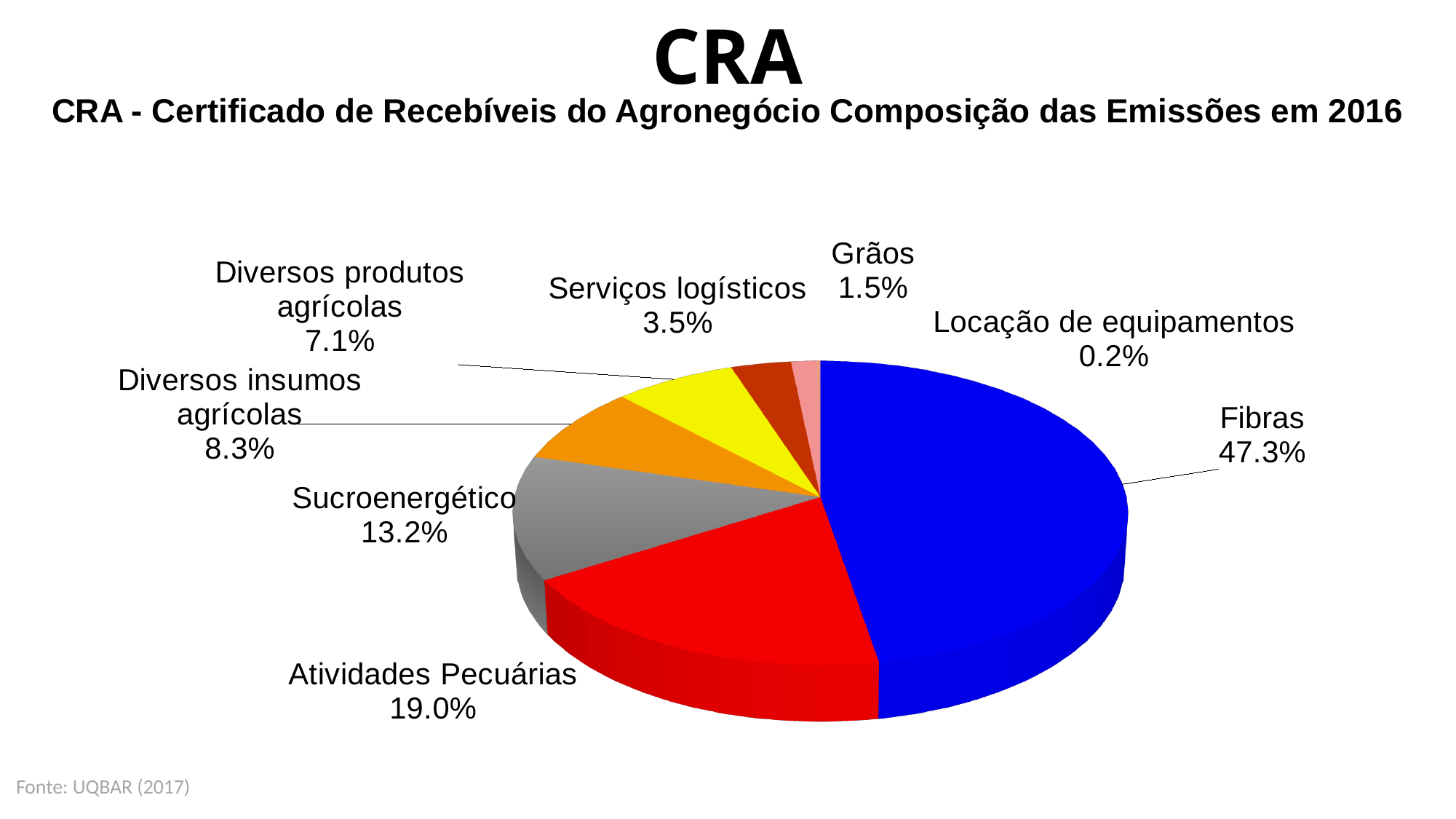
What is the value for Diversos insumos agrícolas? 8.3% What is the difference between the shares of Fibras and Atividades Pecuárias? 28.3% What type of chart is shown on the slide? Pie chart What share of the pie does Fibras represent? 47.3% How many categories are shown in the pie chart? 8 What is the value for Locação de equipamentos? 0.2% Which category has the largest slice of the pie? Fibras What percentage is shown for Sucroenergético? 13.2% Which category has the smallest slice of the pie? Locação de equipamentos What is the value shown for Atividades Pecuárias? 19.0% What colour is the Fibras slice? Blue Which is larger, Diversos insumos agrícolas or Diversos produtos agrícolas? Diversos insumos agrícolas